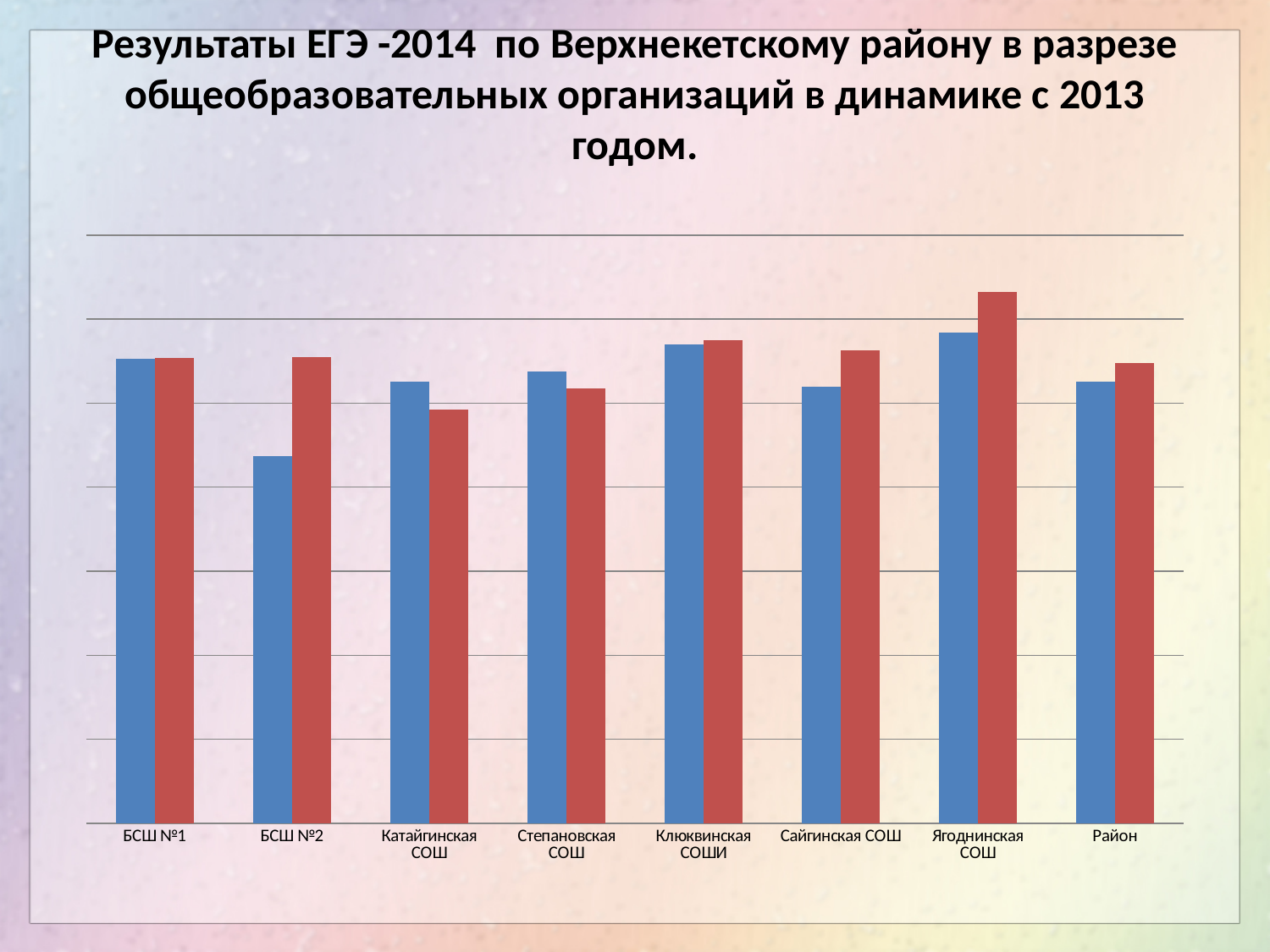
For Степановская СОШ, which bar is taller, the blue one or the red one? blue How many bars are plotted for each category in the chart? 2 Which category has the tallest red bar? Ягоднинская СОШ For Катайгинская СОШ, which bar is taller, the blue one or the red one? blue Which category has the tallest blue bar? Ягоднинская СОШ Which category has the shortest blue bar? БСШ №2 What is the label of the last category on the x axis? Район Which category has the shortest red bar? Катайгинская СОШ For БСШ №2, which bar is taller, the blue one or the red one? red How many categories are shown along the x axis of the chart? 8 What kind of chart is shown on the slide? bar chart